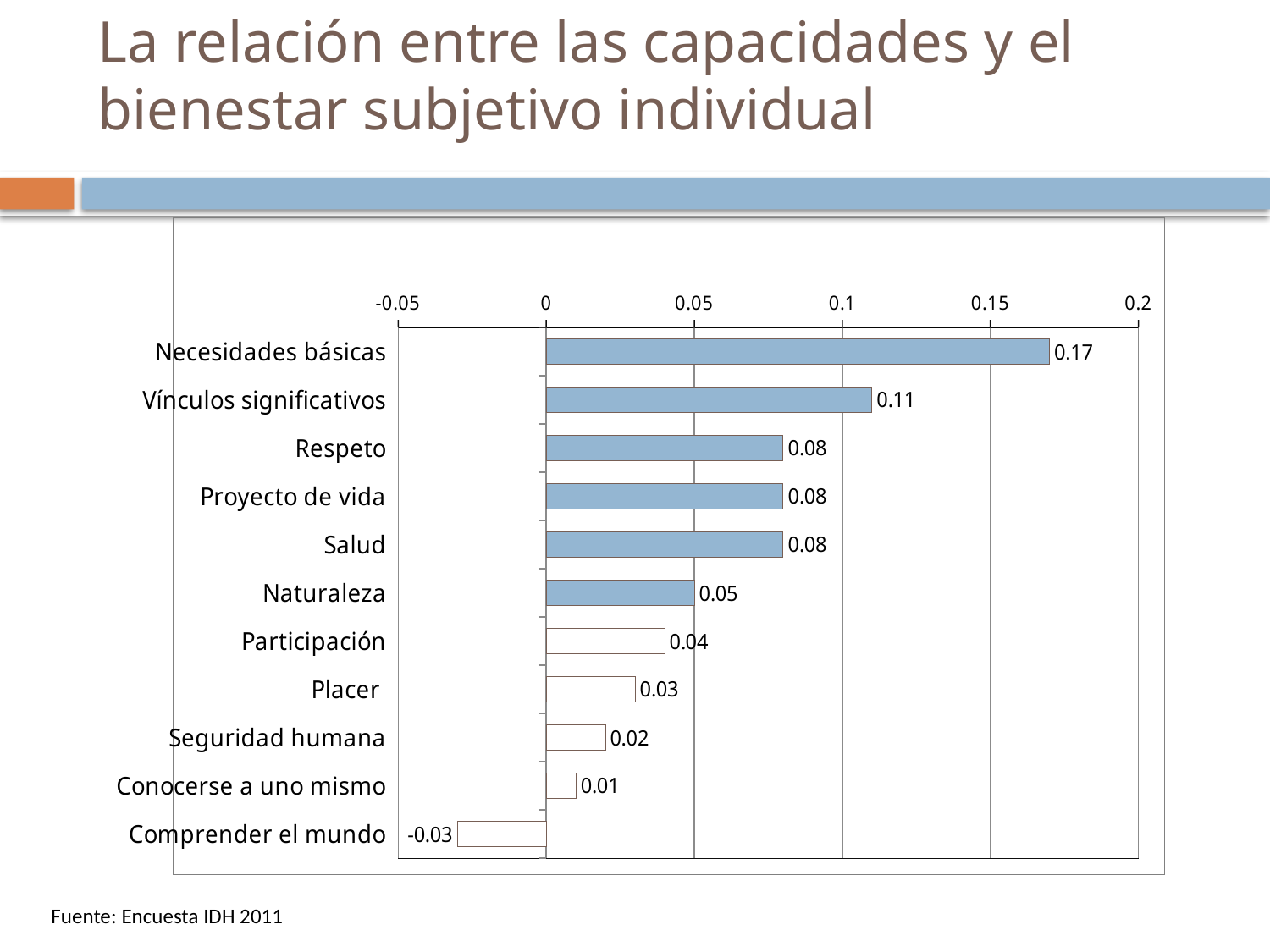
Is the value for Vínculos significativos greater or less than 0.1? greater Which category has the lowest value? Comprender el mundo What is the value for Necesidades básicas? 0.17 Which is larger, the value for Participación or the value for Placer? Participación How many categories have a value of 0.08? 3 What is the value for Seguridad humana? 0.02 What is the difference between the values for Necesidades básicas and Vínculos significativos? 0.06 What is the value for Naturaleza? 0.05 Which category has the highest value? Necesidades básicas How many categories are shown in the chart? 11 What is the value for Comprender el mundo? -0.03 What kind of chart is shown on the slide? bar chart